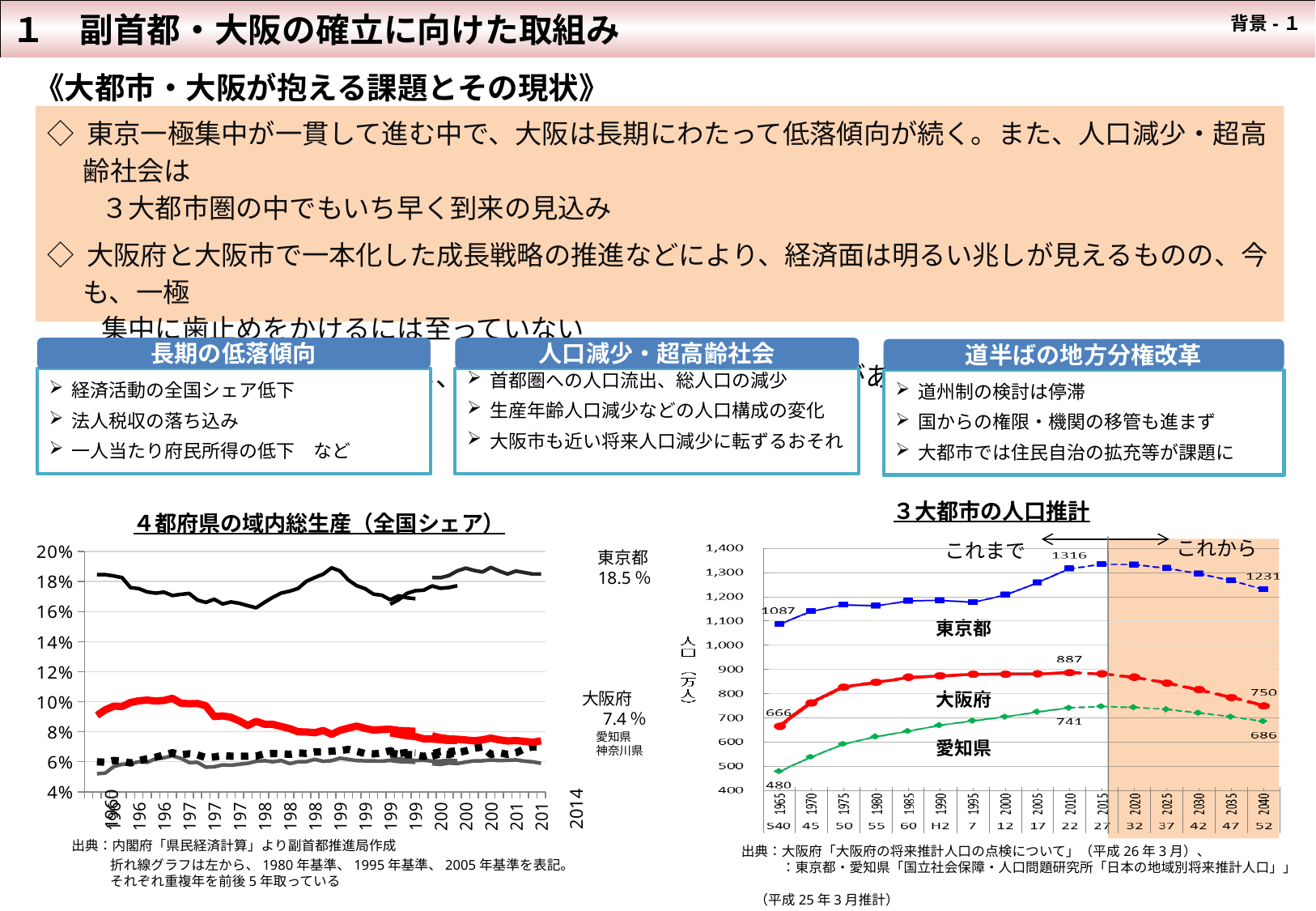
In the chart titled ３大都市の人口推計, is the 2040 value for 愛知県 greater or less than 700? less In the chart titled ４都府県の域内総生産（全国シェア）, what is the labelled share for 東京都 at the end of the series? 18.5％ In the chart titled ３大都市の人口推計, which prefecture has the lowest population in 1965? 愛知県 In the chart titled ４都府県の域内総生産（全国シェア）, what is the labelled share for 大阪府 at the end of the series? 7.4％ In the chart titled ３大都市の人口推計, which prefecture has the highest population throughout the chart? 東京都 In the chart titled ３大都市の人口推計, what is the labelled population value for 東京都 in 2040? 1231 In the chart titled ４都府県の域内総生産（全国シェア）, does the share for 大阪府 rise or fall from 1960 to 2014? fall In the chart titled ３大都市の人口推計, what is the labelled population value for 愛知県 in 1965? 480 In the chart titled ３大都市の人口推計, what is the labelled population value for 東京都 in 1965? 1087